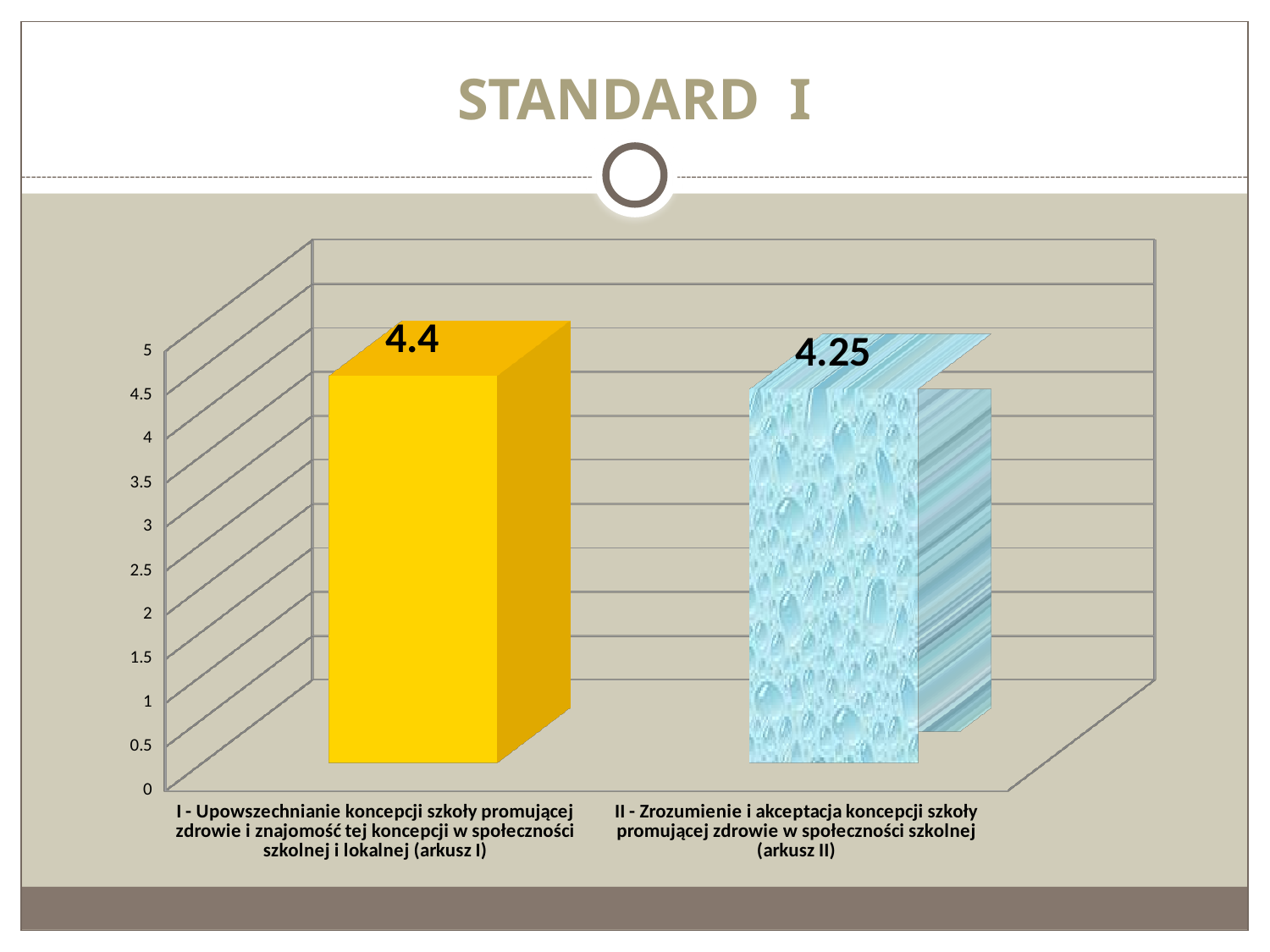
What is the title of the slide? STANDARD I What is the value for category I (Upowszechnianie koncepcji szkoły promującej zdrowie... arkusz I)? 4.4 What kind of chart is shown on the slide? Bar chart Is the value for category II (arkusz II) greater or less than 4? greater What is the difference between the values for category I and category II? 0.15 Which is larger, the value for category I (arkusz I) or category II (arkusz II)? Category I (arkusz I) What is the value for category II (Zrozumienie i akceptacja koncepcji szkoły promującej zdrowie... arkusz II)? 4.25 What is the maximum value shown on the vertical axis? 5 Is the value for category I (arkusz I) greater or less than 5? less Which category has the highest value? I - Upowszechnianie koncepcji szkoły promującej zdrowie i znajomość tej koncepcji w społeczności szkolnej i lokalnej (arkusz I) How many categories are shown in the chart? 2 Which category has the lowest value? II - Zrozumienie i akceptacja koncepcji szkoły promującej zdrowie w społeczności szkolnej (arkusz II)